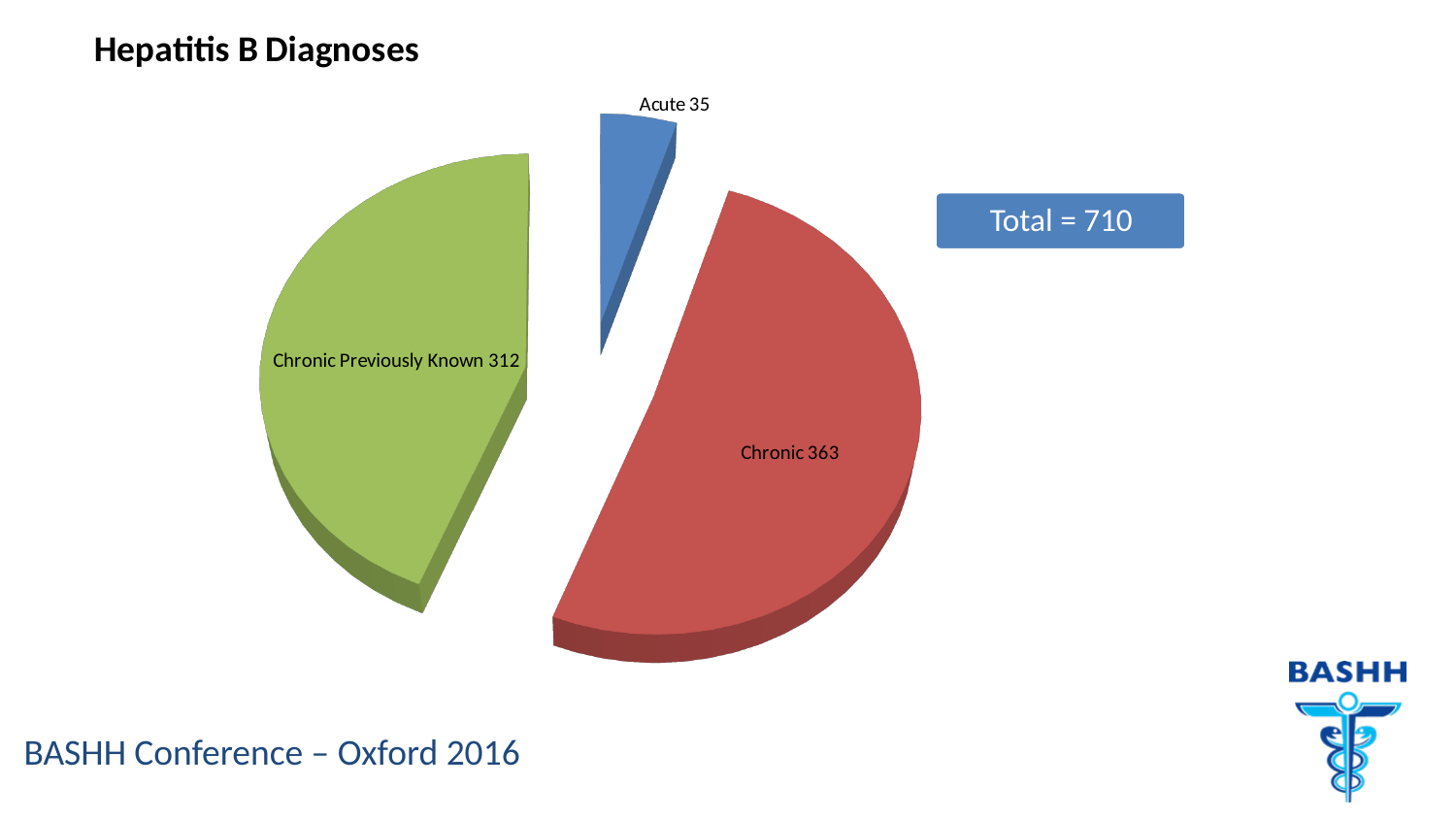
What is the value for Acute? 35 What is the difference between the Chronic and Chronic Previously Known values? 51 Which category has the smallest slice? Acute What is the title of the chart? Hepatitis B Diagnoses What is the difference between the Chronic and Acute values? 328 How many slices does the pie chart have? 3 Which is larger, Chronic Previously Known or Acute? Chronic Previously Known What is the value for Chronic? 363 What is the value for Chronic Previously Known? 312 What total is stated on the slide for the diagnoses? 710 Which category has the largest slice? Chronic What kind of chart is shown on the slide? Pie chart